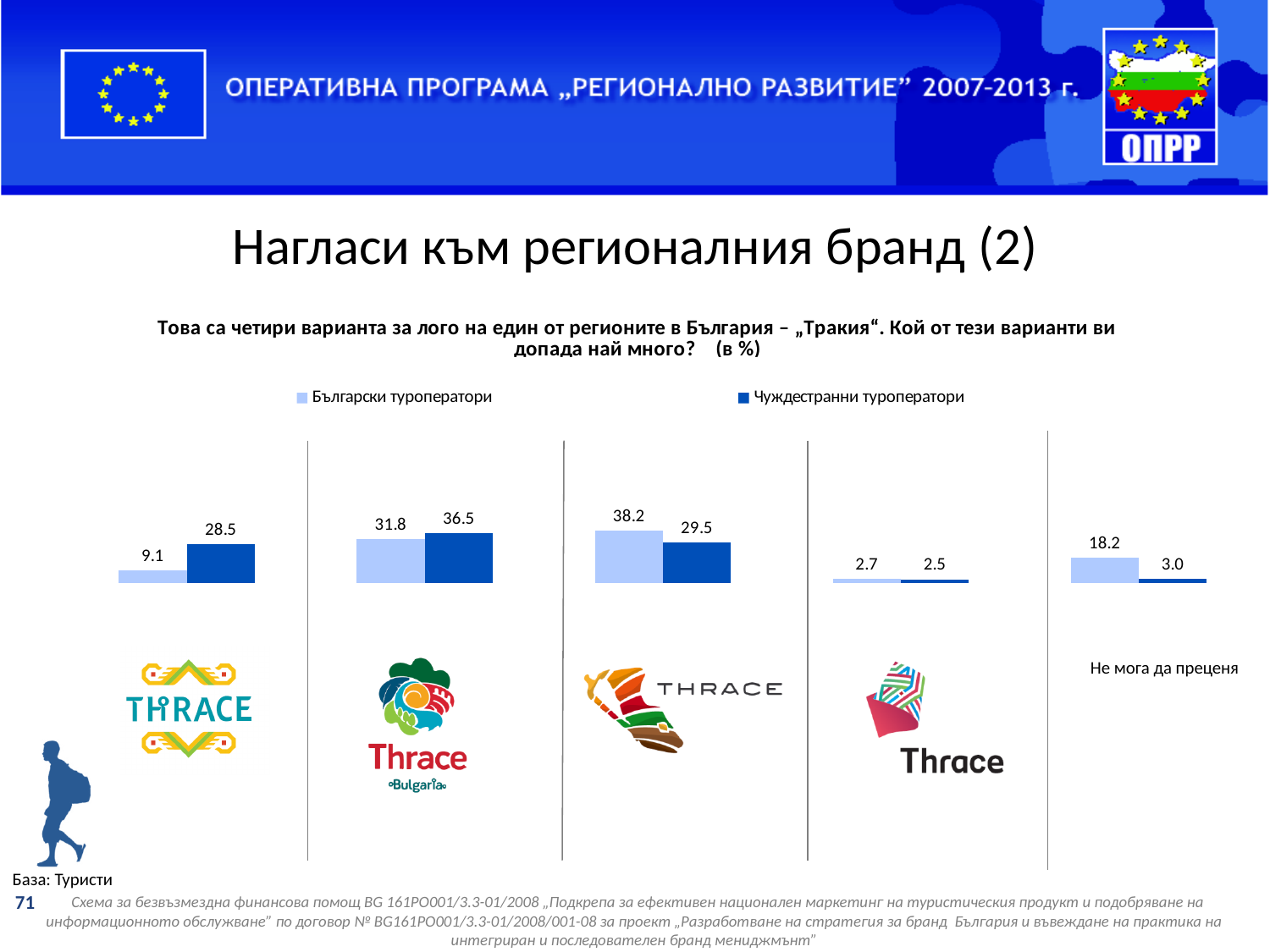
What is the difference between the Чуждестранни туроператори and Български туроператори values for the first (leftmost) logo variant? 19.4 Which category has the lowest value for Чуждестранни туроператори? the fourth logo variant from the left (2.5) Which logo variant has the highest value for Български туроператори? the third logo variant from the left (38.2) What is the value for Български туроператори for the category 'Не мога да преценя'? 18.2 How many series does the chart legend list? 2 What are the two series named in the chart legend? Български туроператори and Чуждестранни туроператори What kind of chart is shown on the slide? bar chart For the second logo variant from the left, which series has the larger value, Български туроператори or Чуждестранни туроператори? Чуждестранни туроператори What is the value for Български туроператори for the third logo variant from the left? 38.2 How many categories are shown on the x axis of the chart? 5 What is the value for Чуждестранни туроператори for the first (leftmost) logo variant? 28.5 What is the value for Чуждестранни туроператори for the category 'Не мога да преценя'? 3.0